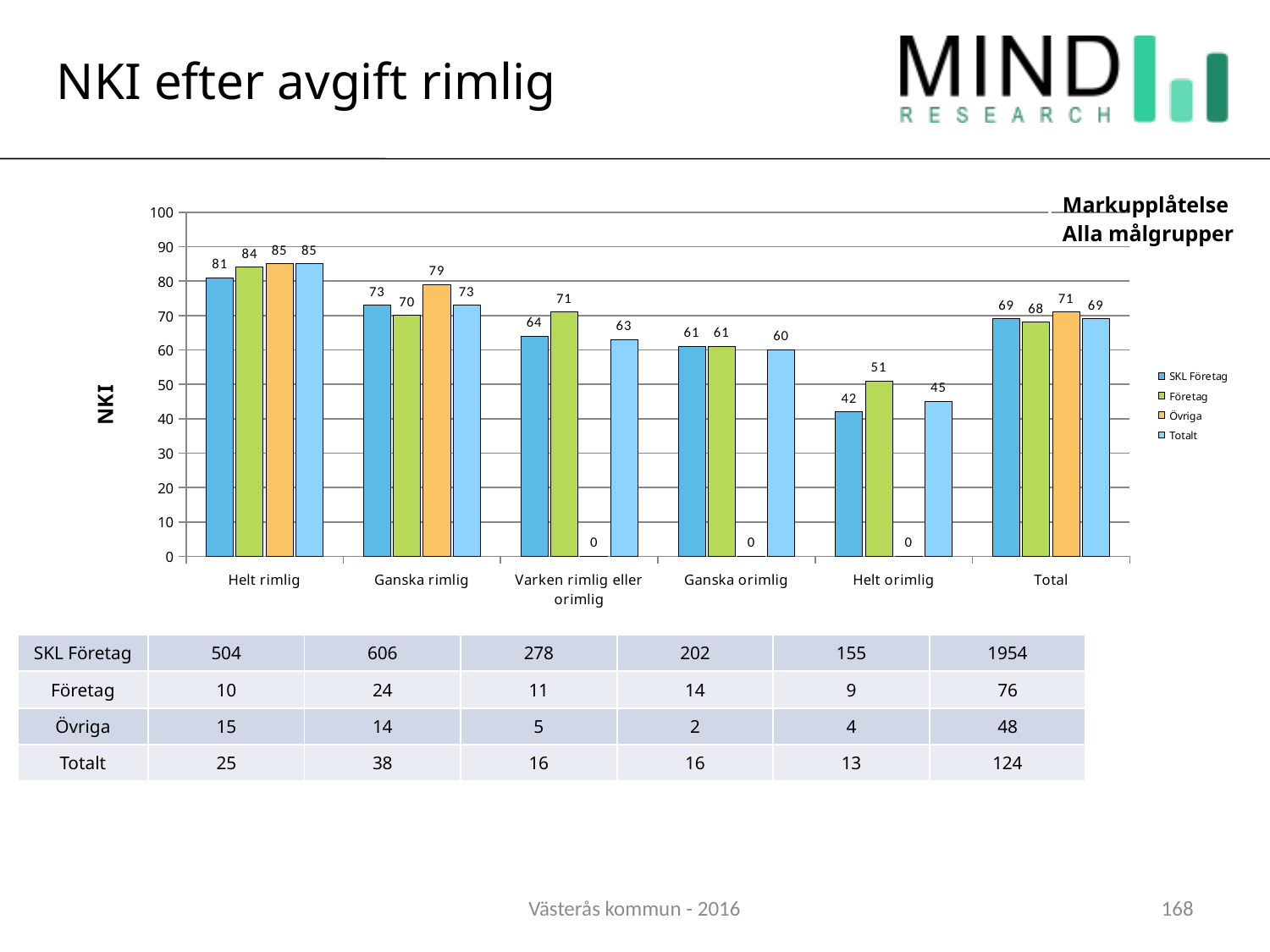
How many categories are shown on the x axis of the chart? 6 What is the label on the y axis of the chart? NKI How many series does the chart legend list? 4 What is the NKI value for SKL Företag in the Helt orimlig category? 42 What is the Totalt value in the Varken rimlig eller orimlig category? 63 What kind of chart is shown on the slide? Bar chart Which category has the highest Totalt value? Helt rimlig Do the Totalt values rise or fall from Helt rimlig to Helt orimlig? Fall What is the difference between the Företag value for Helt rimlig and the Företag value for Helt orimlig? 33 Which category has the lowest SKL Företag value? Helt orimlig Which is larger: the SKL Företag value for Ganska rimlig or the Företag value for Ganska rimlig? SKL Företag What is the NKI value for Övriga in the Ganska rimlig category? 79